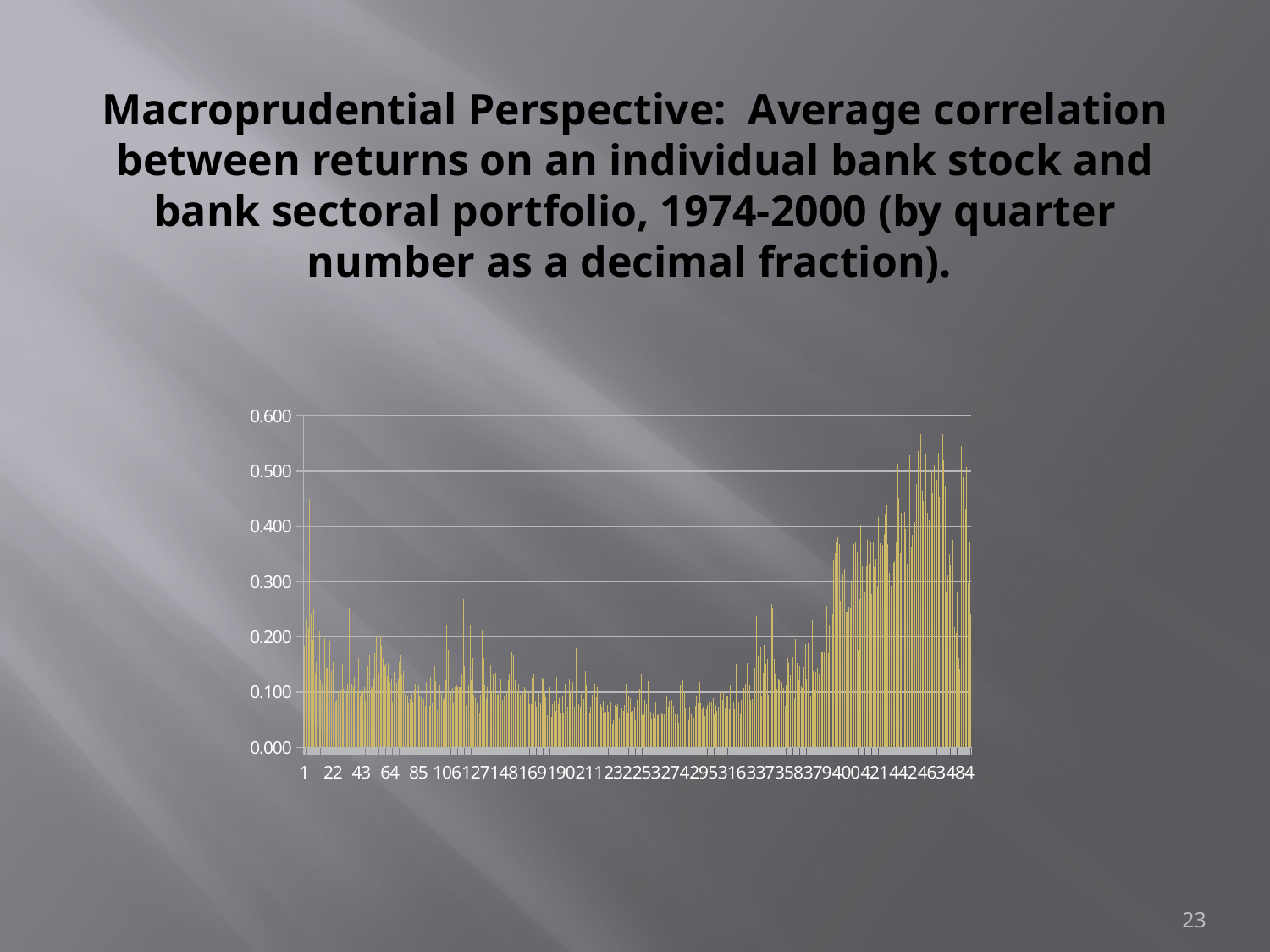
Is the tallest bar in the chart greater or less than 0.500? greater How many tick labels are printed along the x axis of the chart? 24 Which part of the x axis contains the tallest bars: the left end (near 1), the middle (near 253), or the right end (near 484)? the right end (near 484) Is the tallest bar in the chart greater or less than 0.600? less What is the first label shown on the x axis of the chart? 1 What is the lowest value shown on the y axis of the chart? 0.000 Do the bar values generally rise or fall over the right-hand portion of the x axis (from around 379 to 484)? rise Are the bars in the region around x-axis labels 253 to 295 mostly greater or less than 0.200? less What kind of chart is shown on the slide? bar chart What is the highest value shown on the y axis of the chart? 0.600 What is the last label shown on the x axis of the chart? 484 Which part of the x axis contains the shortest bars: the left end (near 1), the middle (near 253), or the right end (near 484)? the middle (near 253)